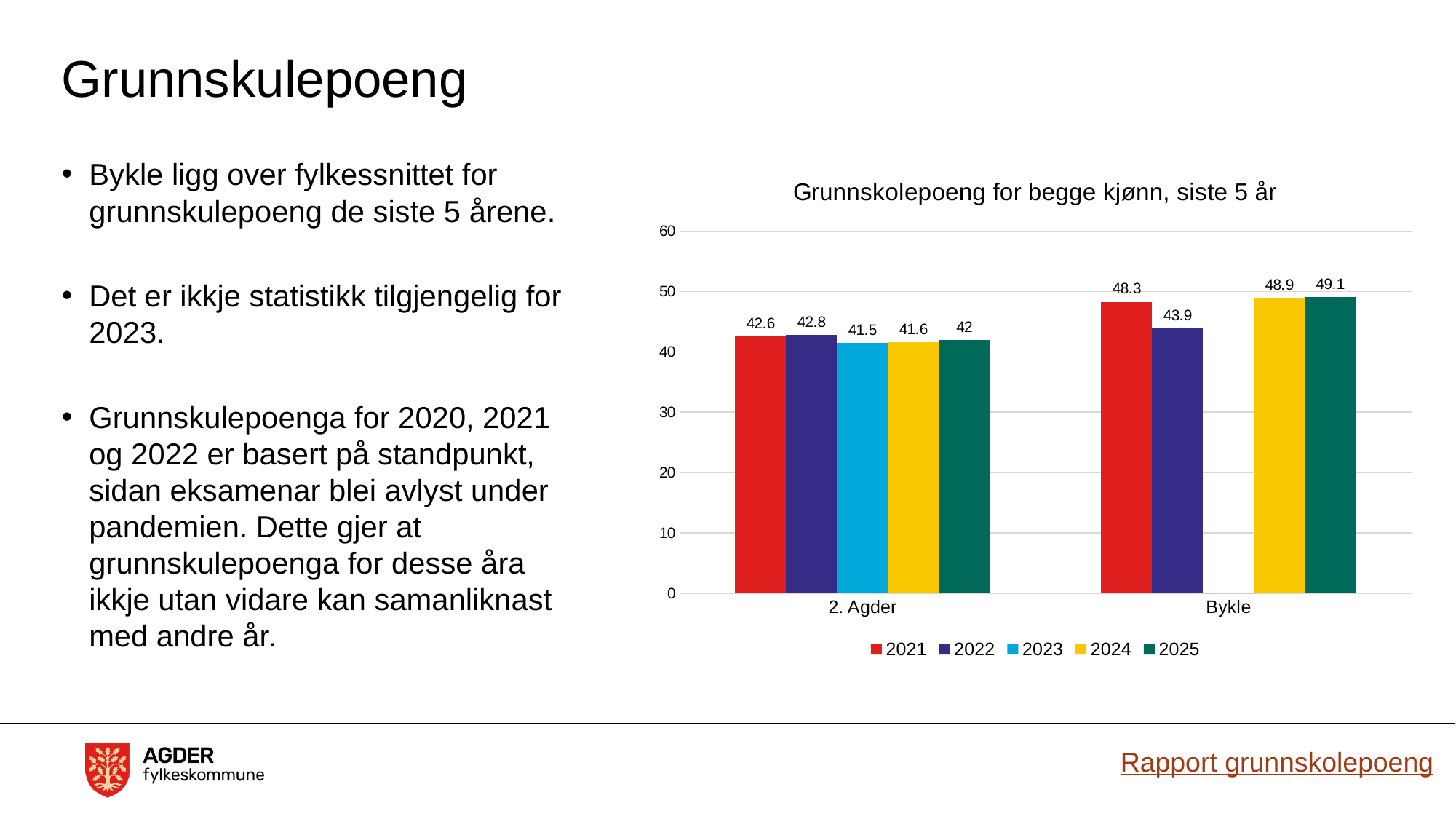
How many series does the legend list? 5 Which is larger, the 2021 value for Bykle or the 2021 value for 2. Agder? Bykle What is the value for Bykle in 2022? 43.9 What is the value for 2. Agder in 2021? 42.6 What is the value for Bykle in 2025? 49.1 Which year has the lowest value for 2. Agder? 2023 What is the value for 2. Agder in 2023? 41.5 What is the title of the chart? Grunnskolepoeng for begge kjønn, siste 5 år What is the difference between Bykle and 2. Agder in 2024? 7.3 What kind of chart is shown on the slide? Bar chart How many categories are shown on the x axis? 2 Which year has the highest value for Bykle? 2025